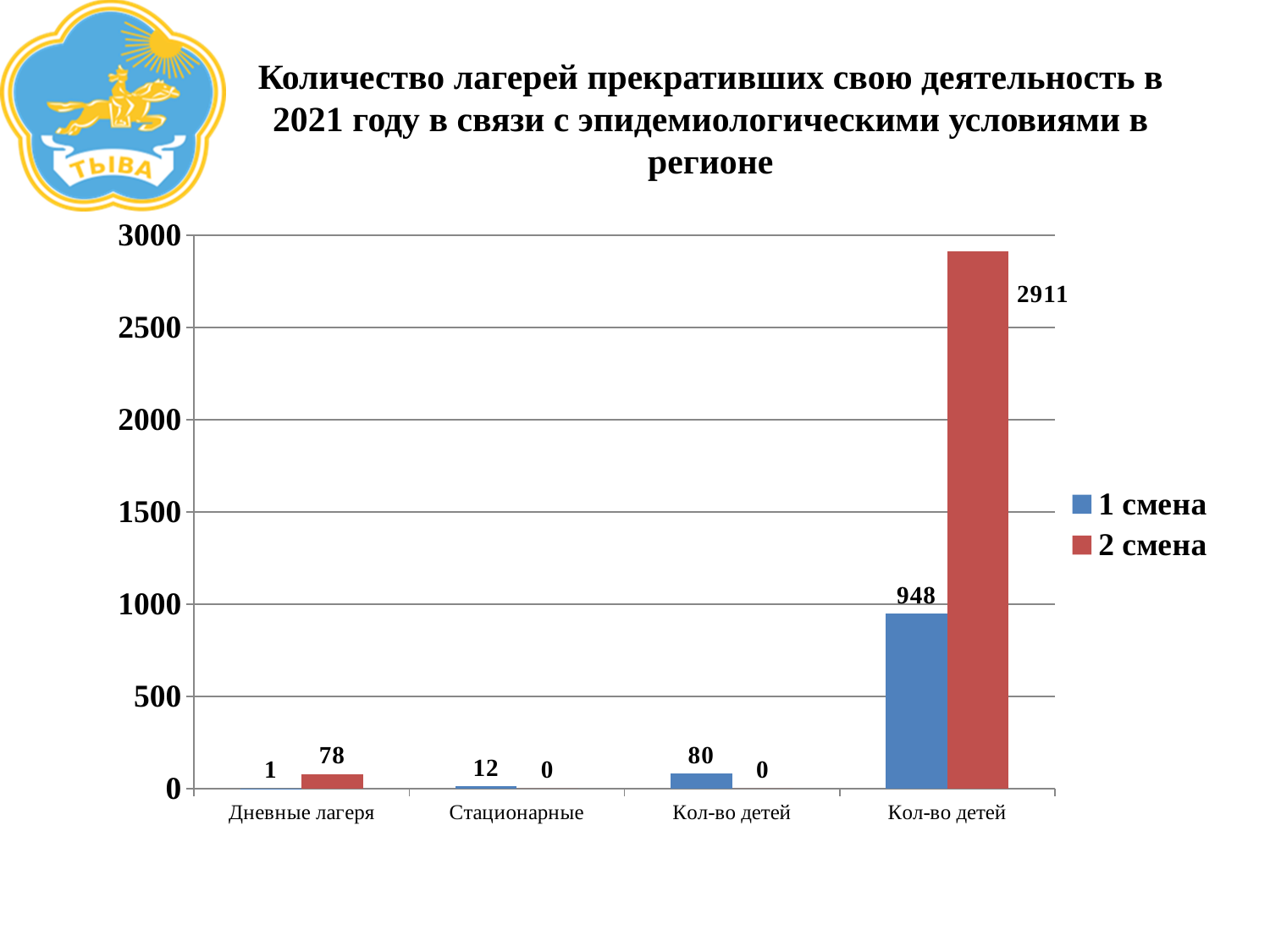
How many series does the legend list? 2 In the "Дневные лагеря" category, which series has the larger value, "1 смена" or "2 смена"? 2 смена What is the difference between the "2 смена" and "1 смена" values in the rightmost category? 1963 What kind of chart is shown on the slide? Bar chart How many categories are shown on the x axis? 4 What is the value for "2 смена" in the "Стационарные" category? 0 What is the value for "1 смена" in the rightmost category (the fourth "Кол-во детей")? 948 Which series has the highest value in the rightmost category? 2 смена What is the value for "1 смена" in the "Дневные лагеря" category? 1 What is the value for "1 смена" in the "Стационарные" category? 12 What is the value for "2 смена" in the rightmost category (the fourth "Кол-во детей")? 2911 What is the value for "2 смена" in the "Дневные лагеря" category? 78